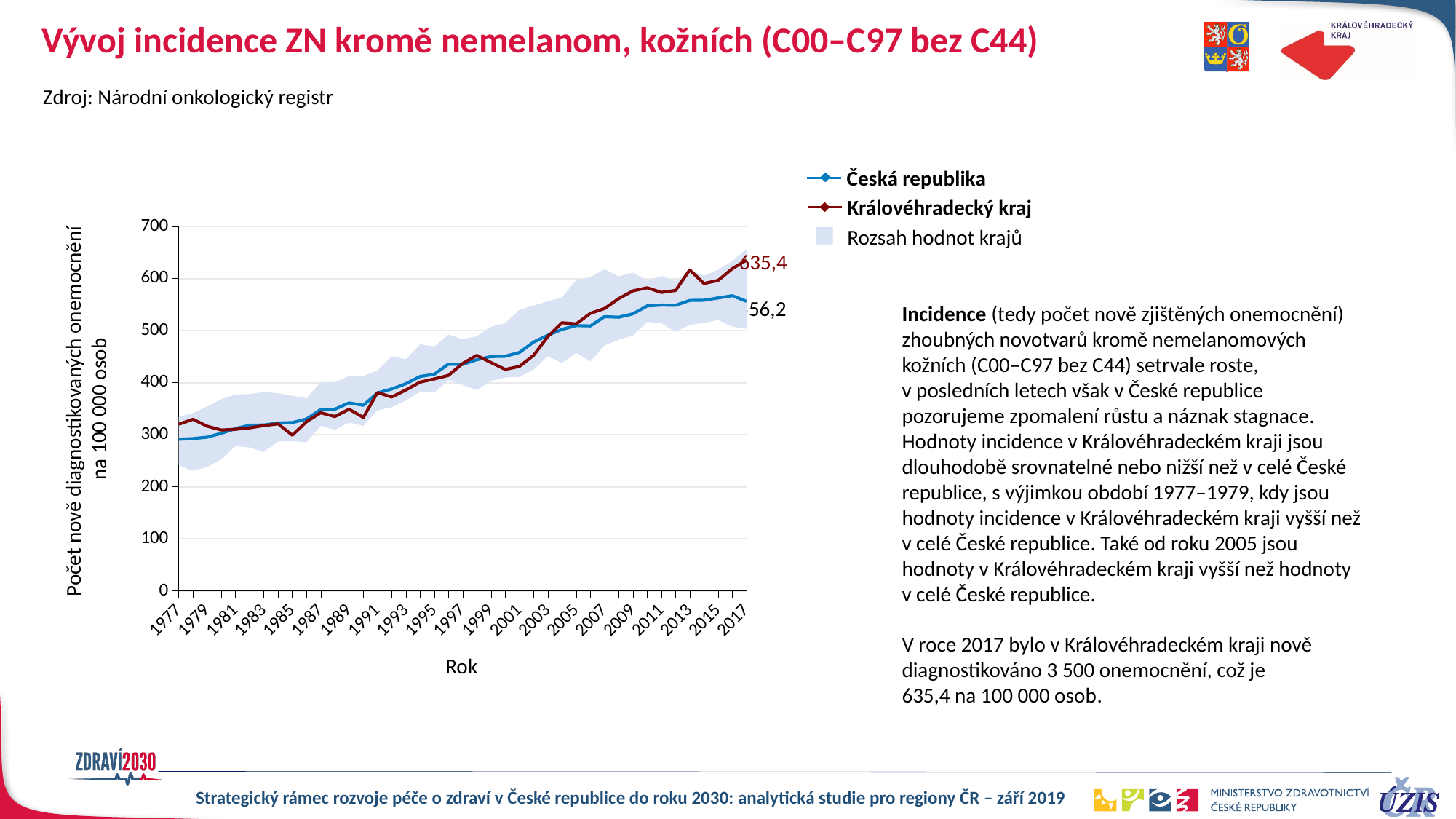
Do the values for Česká republika generally rise or fall from 1977 to 2017? rise Is the value for Česká republika in 1977 greater or less than 400? less Is the value for Královéhradecký kraj in 2017 greater or less than 600? greater In 2001, which series has the higher value, Česká republika or Královéhradecký kraj? Česká republika How many entries does the chart legend list? 3 In which year does the Královéhradecký kraj series reach its highest value? 2017 In 2017, which series has the higher value, Česká republika or Královéhradecký kraj? Královéhradecký kraj Is the value for Česká republika in 2017 greater or less than 500? greater What is the highest value shown on the y axis? 700 What kind of chart is shown on the slide? line chart What is the title of the x axis? Rok What is the value for Královéhradecký kraj in 2017? 635,4